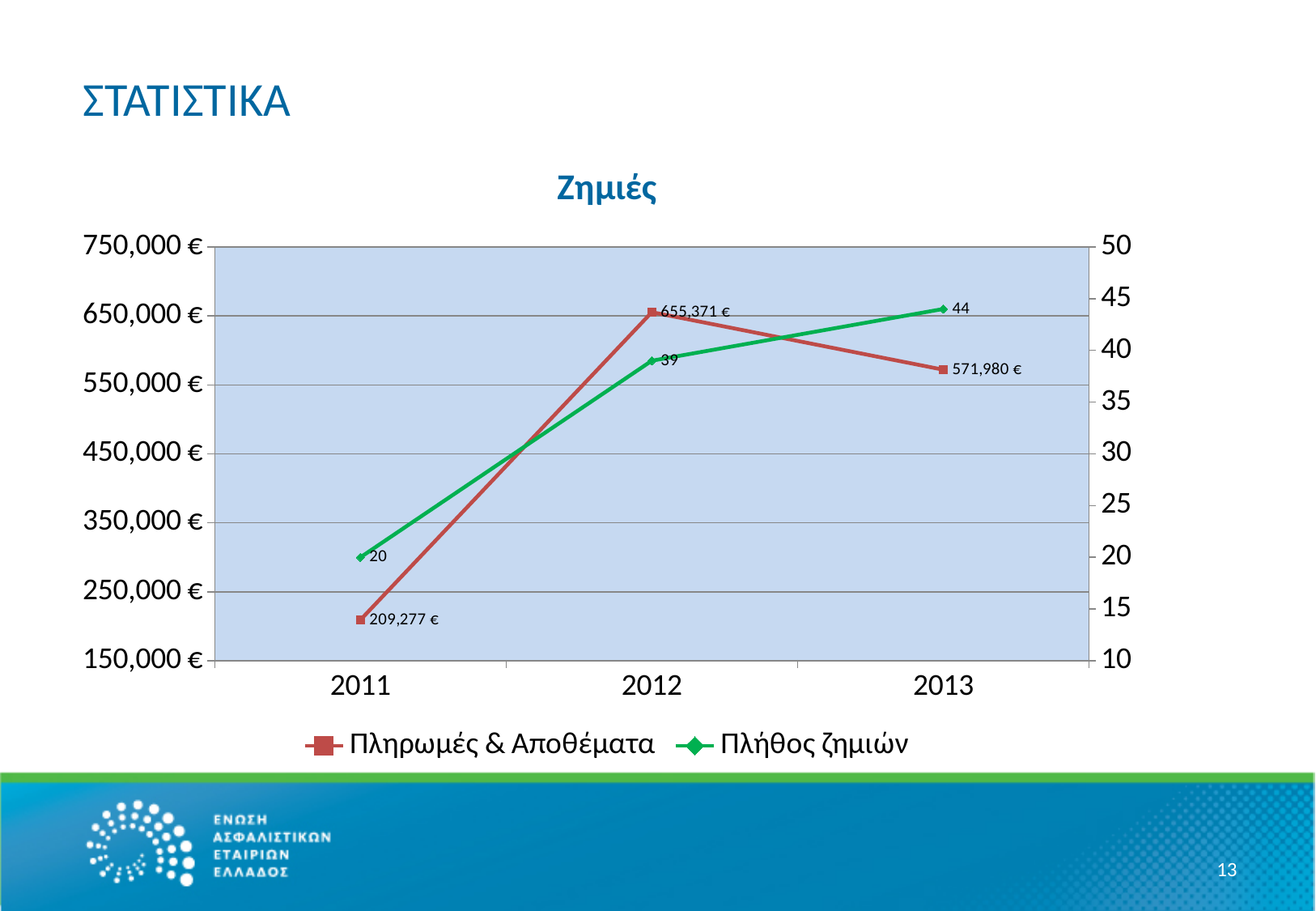
Which is larger for Πληρωμές & Αποθέματα: the value in 2012 or the value in 2013? 2012 What is the value of Πληρωμές & Αποθέματα in 2013? 571,980 € What is the value of Πλήθος ζημιών in 2011? 20 What is the value of Πληρωμές & Αποθέματα in 2012? 655,371 € What is the value of Πλήθος ζημιών in 2013? 44 How many years are shown on the x axis? 3 What is the difference between Πλήθος ζημιών in 2013 and in 2012? 5 In which year is Πληρωμές & Αποθέματα highest? 2012 How many series does the legend list? 2 What is the difference between Πληρωμές & Αποθέματα in 2012 and in 2011? 446,094 € In which year is Πλήθος ζημιών lowest? 2011 What kind of chart is this? Line chart